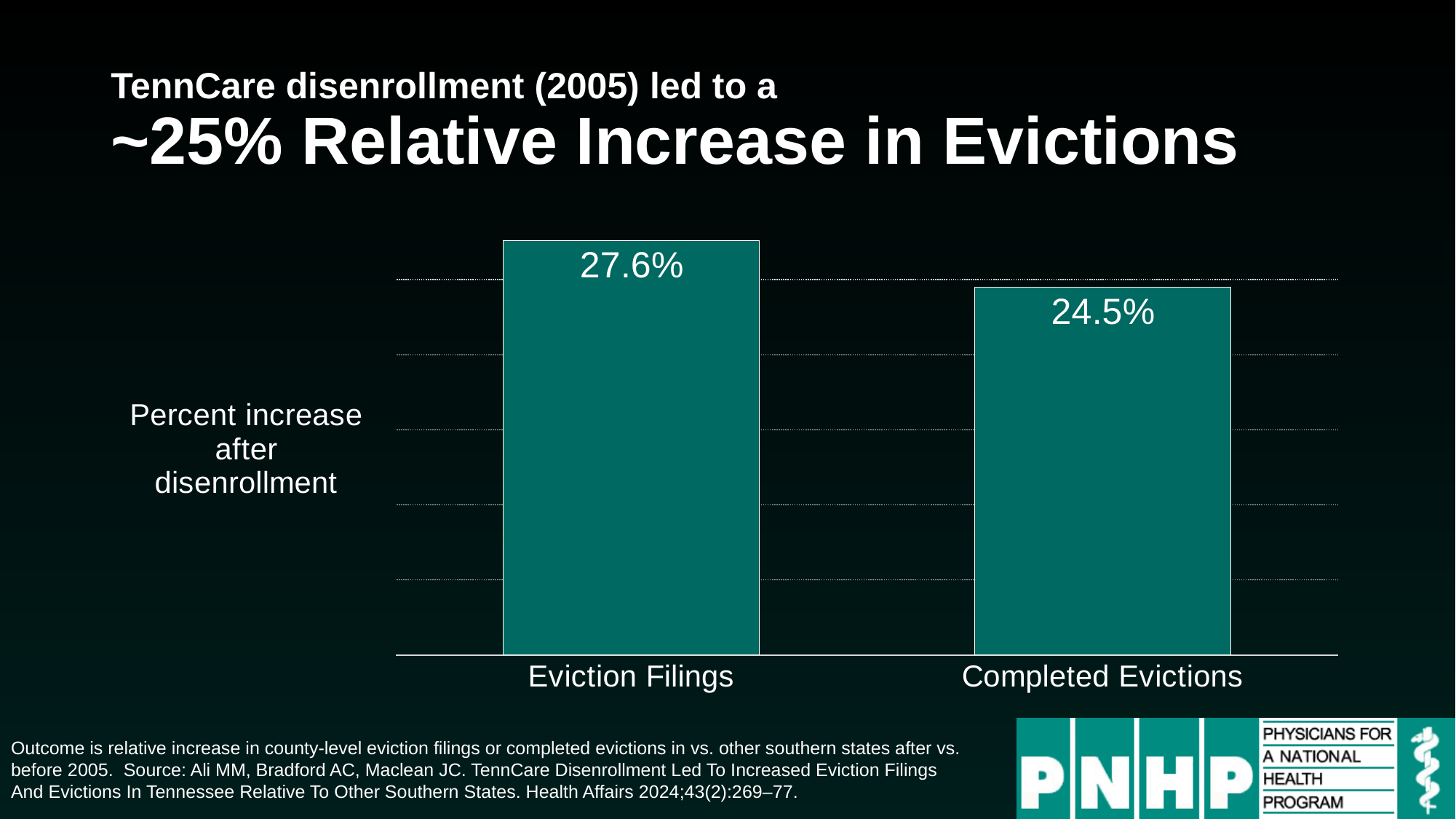
What is the percent increase after disenrollment for Completed Evictions? 24.5% What colour are the bars in the chart? teal What is the label on the vertical axis of the chart? Percent increase after disenrollment Is the value for Eviction Filings larger or smaller than the value for Completed Evictions? larger Which category shows the higher percent increase after disenrollment? Eviction Filings How many categories are plotted on the chart? 2 What is the percent increase after disenrollment for Eviction Filings? 27.6% What kind of chart is shown on the slide? bar chart Which category shows the lower percent increase after disenrollment? Completed Evictions What is the difference in percentage points between the increase for Eviction Filings and Completed Evictions? 3.1